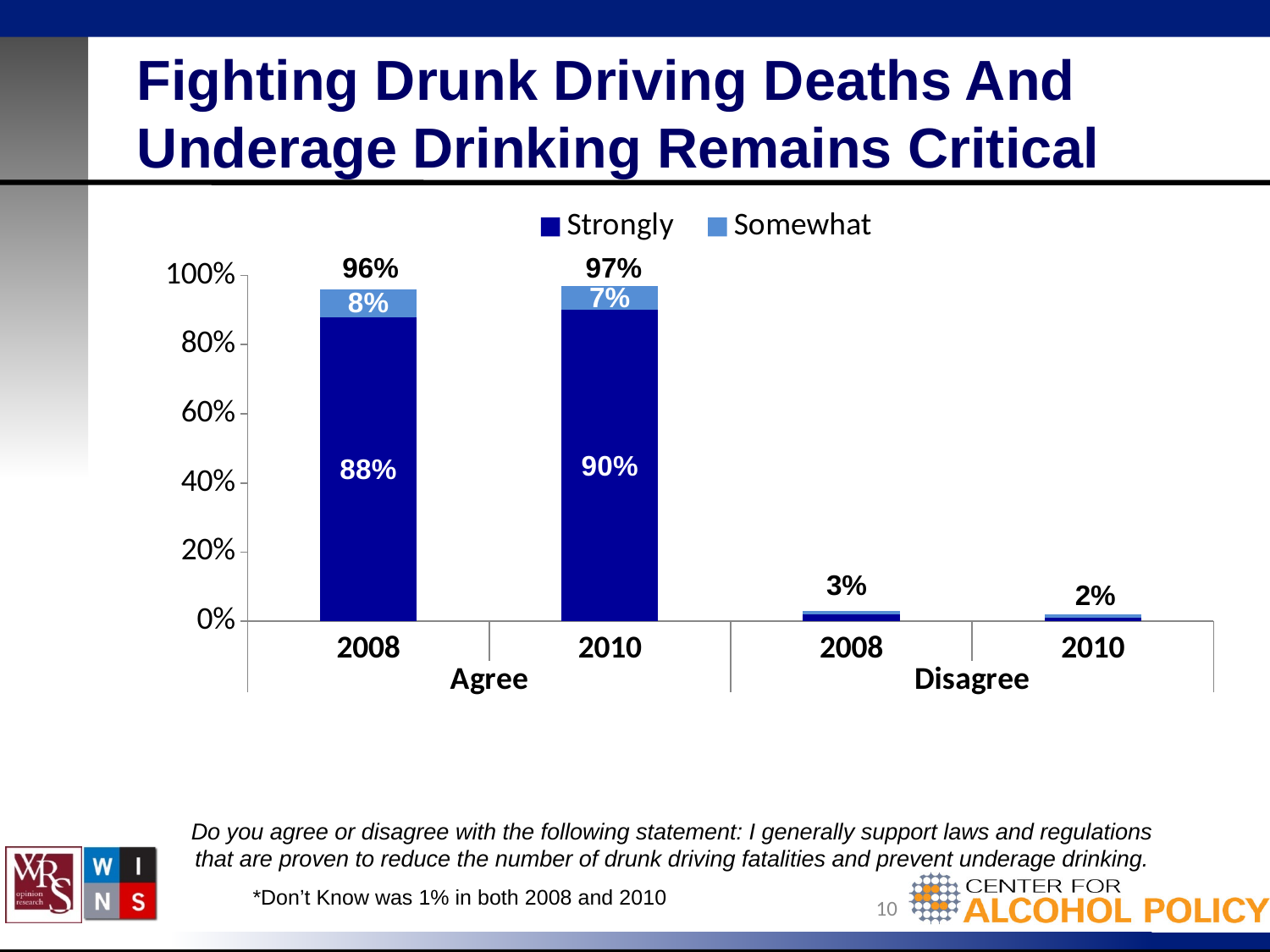
What percentage of respondents strongly agreed in 2008? 88% Which is larger, the Somewhat agree value in 2008 or in 2010? 2008 What percentage of respondents somewhat agreed in 2010? 7% What kind of chart is shown on the slide? Stacked bar chart Which year and response group has the highest total bar? 2010 Agree Which year and response group has the lowest total bar? 2010 Disagree What is the difference between the Strongly agree values for 2010 and 2008? 2% Which legend entry is shown in dark blue? Strongly How many bars are plotted in the chart? 4 How many series does the legend list? 2 What is the total Agree percentage shown for 2010? 97% What is the total Disagree percentage shown for 2008? 3%